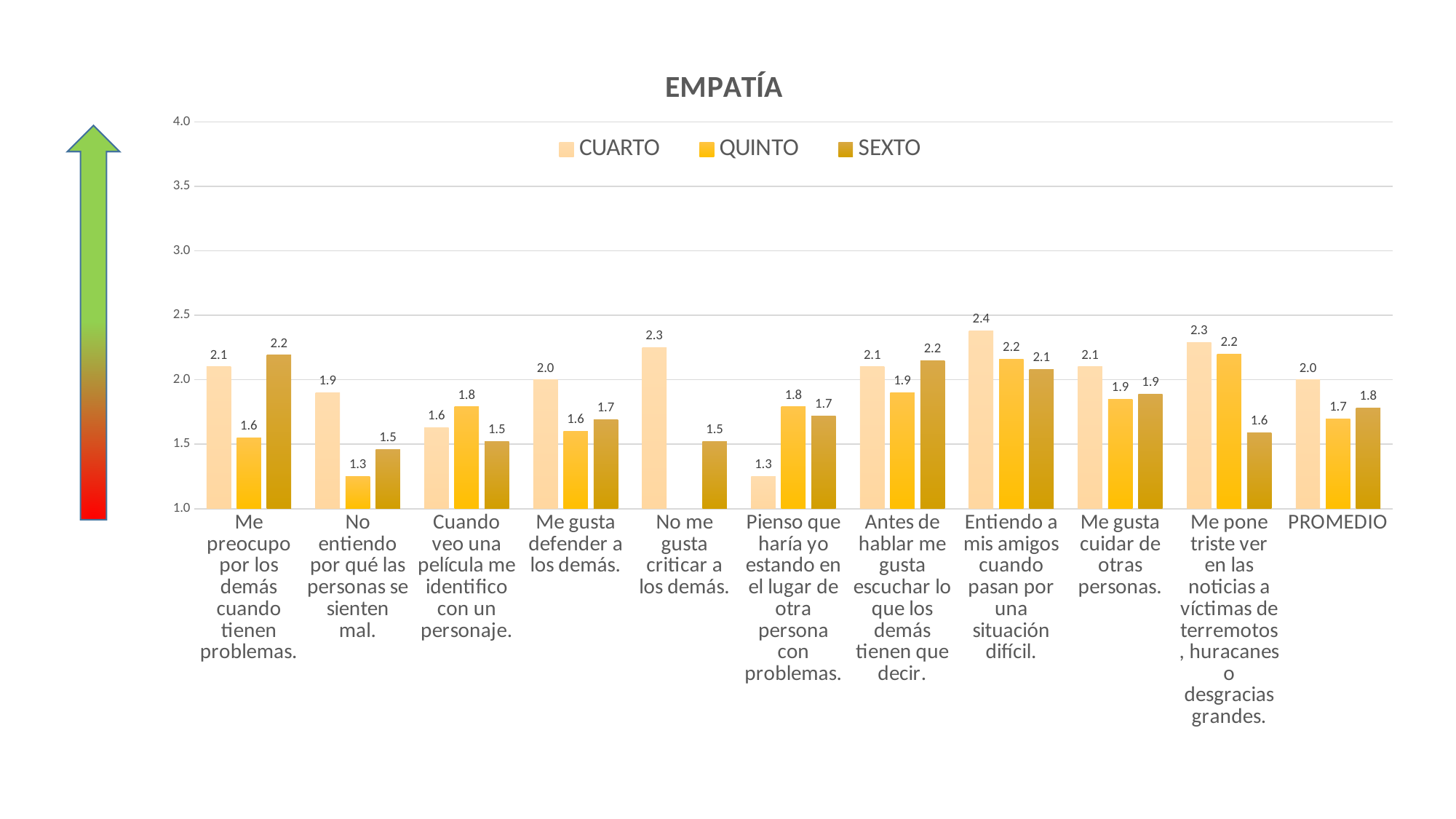
What is the difference between the CUARTO and QUINTO values for "Me pone triste ver en las noticias a víctimas de terremotos, huracanes o desgracias grandes"? 0.1 For "Cuando veo una película me identifico con un personaje", which is larger: the CUARTO value or the QUINTO value? QUINTO What is the CUARTO value for PROMEDIO? 2.0 What type of chart is shown on the slide? bar chart What is the title of the chart? EMPATÍA What is the SEXTO value for "Me preocupo por los demás cuando tienen problemas"? 2.2 How many categories are shown on the x axis? 11 Which category has the highest CUARTO value? Entiendo a mis amigos cuando pasan por una situación difícil. What is the QUINTO value for "No entiendo por qué las personas se sienten mal"? 1.3 How many series does the legend list? 3 What is the difference between the SEXTO and QUINTO values for PROMEDIO? 0.1